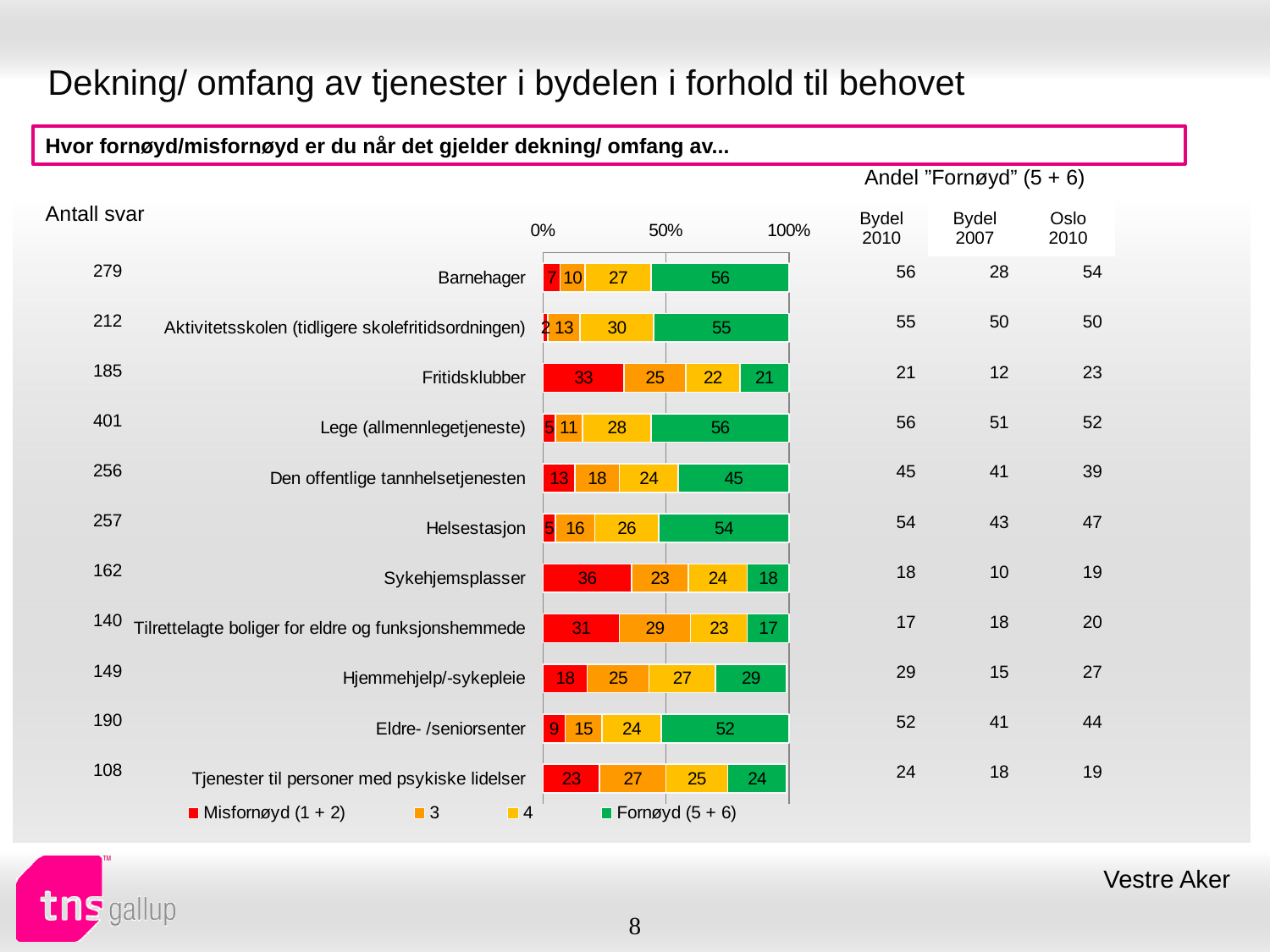
What is the value of the Misfornøyd (1 + 2) segment for Fritidsklubber? 33 How many categories are shown in the chart? 11 Which has a larger Fornøyd (5 + 6) value, Helsestasjon or Eldre-/seniorsenter? Helsestasjon What is the difference between the Fornøyd (5 + 6) values for Barnehager and Fritidsklubber? 35 Which category has the smallest Fornøyd (5 + 6) segment? Tilrettelagte boliger for eldre og funksjonshemmede What is the value of the '3' segment for Hjemmehjelp/-sykepleie? 25 What kind of chart is shown on the slide? Stacked bar chart What is the value of the Fornøyd (5 + 6) segment for Barnehager? 56 What colour represents the Fornøyd (5 + 6) series in the chart? Green How many series does the legend list? 4 What is the value of the '4' segment for Den offentlige tannhelsetjenesten? 24 Which category has the largest Misfornøyd (1 + 2) segment? Sykehjemsplasser